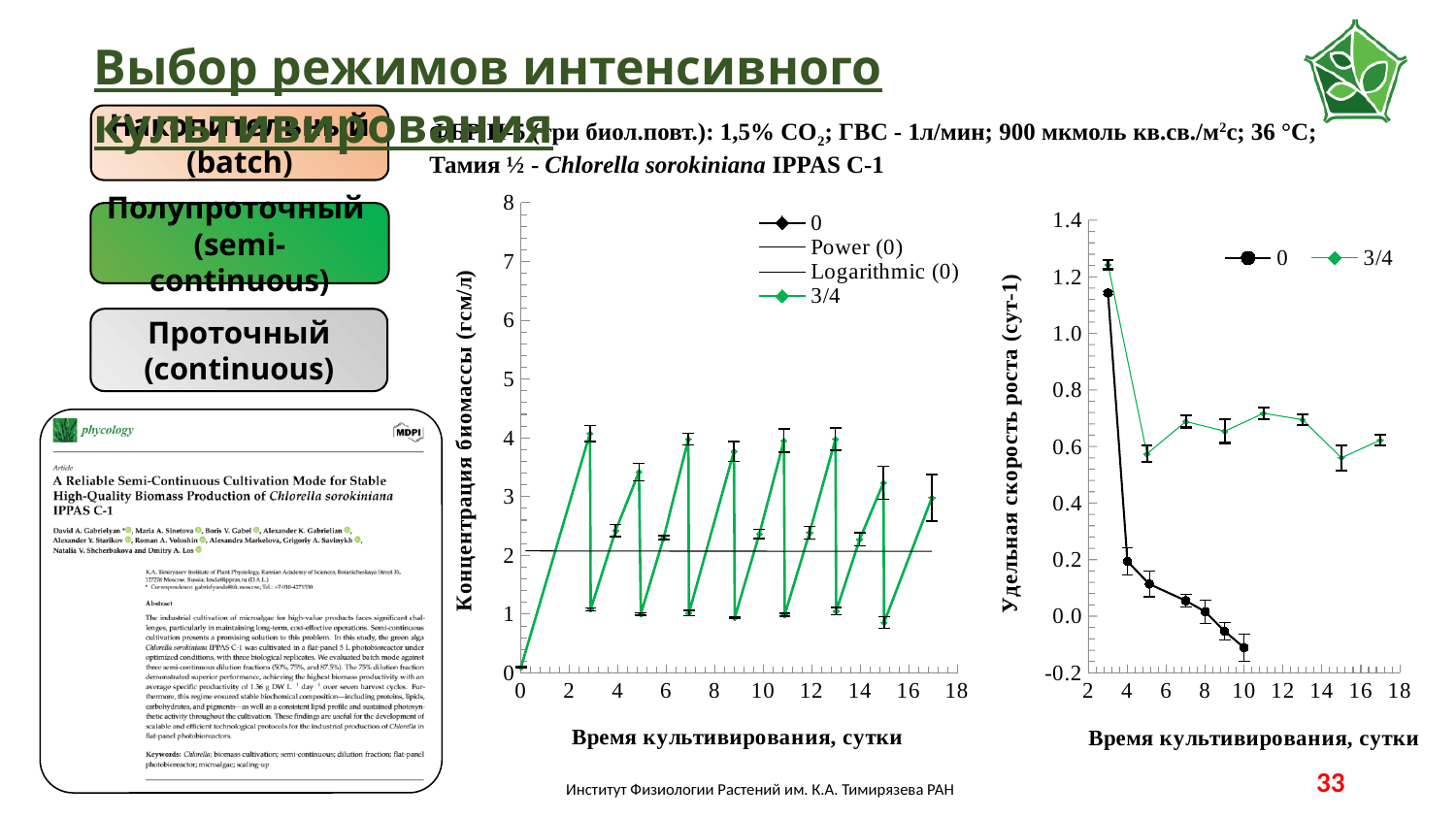
In the right chart (Удельная скорость роста), is the value of series 3/4 at day 3 greater or less than 1.0? greater What is the y-axis title of the left chart? Концентрация биомассы (гсм/л) In the right chart (Удельная скорость роста), which series has the larger value at day 7, 0 or 3/4? 3/4 In the right chart (Удельная скорость роста), which series has the larger value at day 5, 0 or 3/4? 3/4 What is the y-axis title of the right chart? Удельная скорость роста (сут-1) In the left chart (Концентрация биомассы), is the highest value reached by the 3/4 series greater or less than 3? greater In the right chart (Удельная скорость роста), is the value of series 3/4 at day 15 greater or less than 0.8? less How many series does the legend of the left chart (Концентрация биомассы) list? 4 In the right chart (Удельная скорость роста), does the value of the series 0 rise or fall as time increases? fall How many series does the legend of the right chart (Удельная скорость роста) list? 2 What kind of chart is the left chart (Концентрация биомассы)? line chart